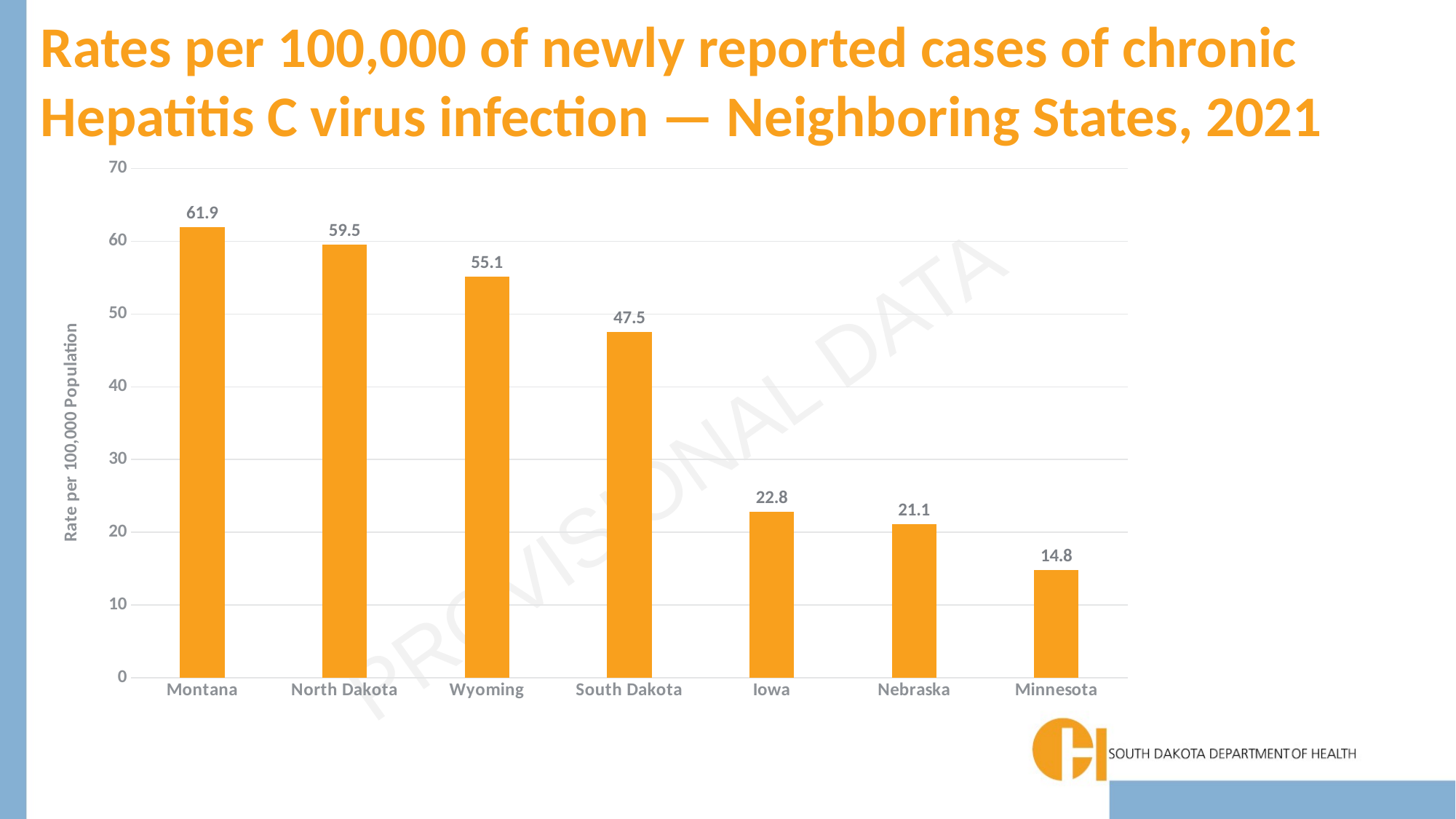
What is the rate per 100,000 for Minnesota? 14.8 What is the difference between the rates for Wyoming and Iowa? 32.3 Which has a higher rate, South Dakota or Nebraska? South Dakota What is the difference between the rates for Montana and North Dakota? 2.4 Which state has the highest rate? Montana What is the rate per 100,000 for South Dakota? 47.5 What kind of chart is shown on the slide? Bar chart Is the value for Iowa greater or less than 30? less What is the rate per 100,000 for Montana? 61.9 Which state has the lowest rate? Minnesota How many states are shown on the chart? 7 What is the label on the vertical axis? Rate per 100,000 Population